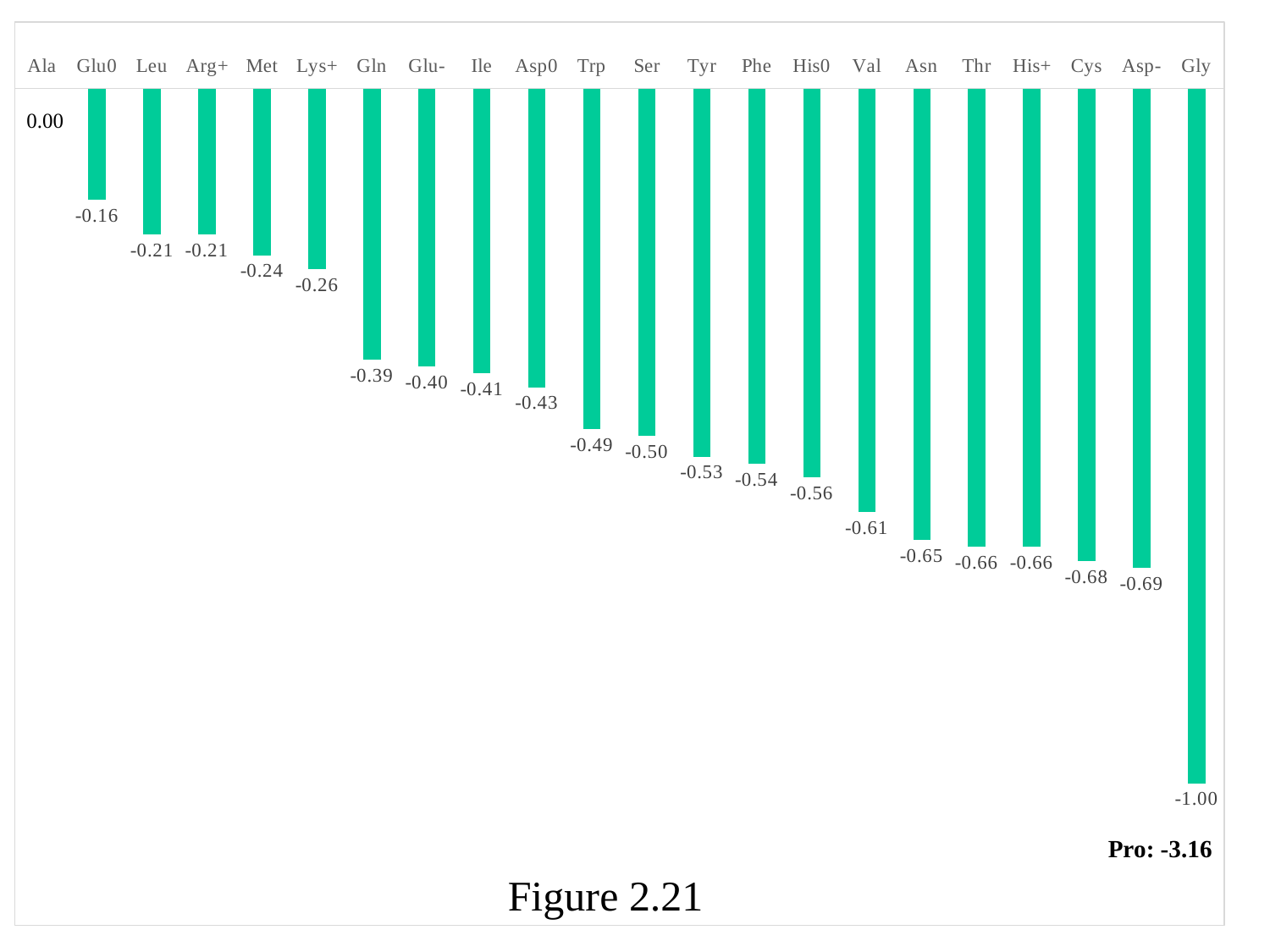
What is the value shown for Gly? -1.00 Which category has the highest value? Ala Which category has the lowest plotted bar value? Gly What is the value shown for Val? -0.61 What value is given for Pro in the text annotation on the chart? -3.16 What is the difference between the values for Glu0 and Gly? 0.84 Do the values rise or fall moving from left to right along the x axis? Fall What is the value shown for Met? -0.24 What is the value shown for Ala? 0.00 How many categories are labelled on the x axis? 22 Which has the larger value, Gln or Asn? Gln What kind of chart is shown? Bar chart